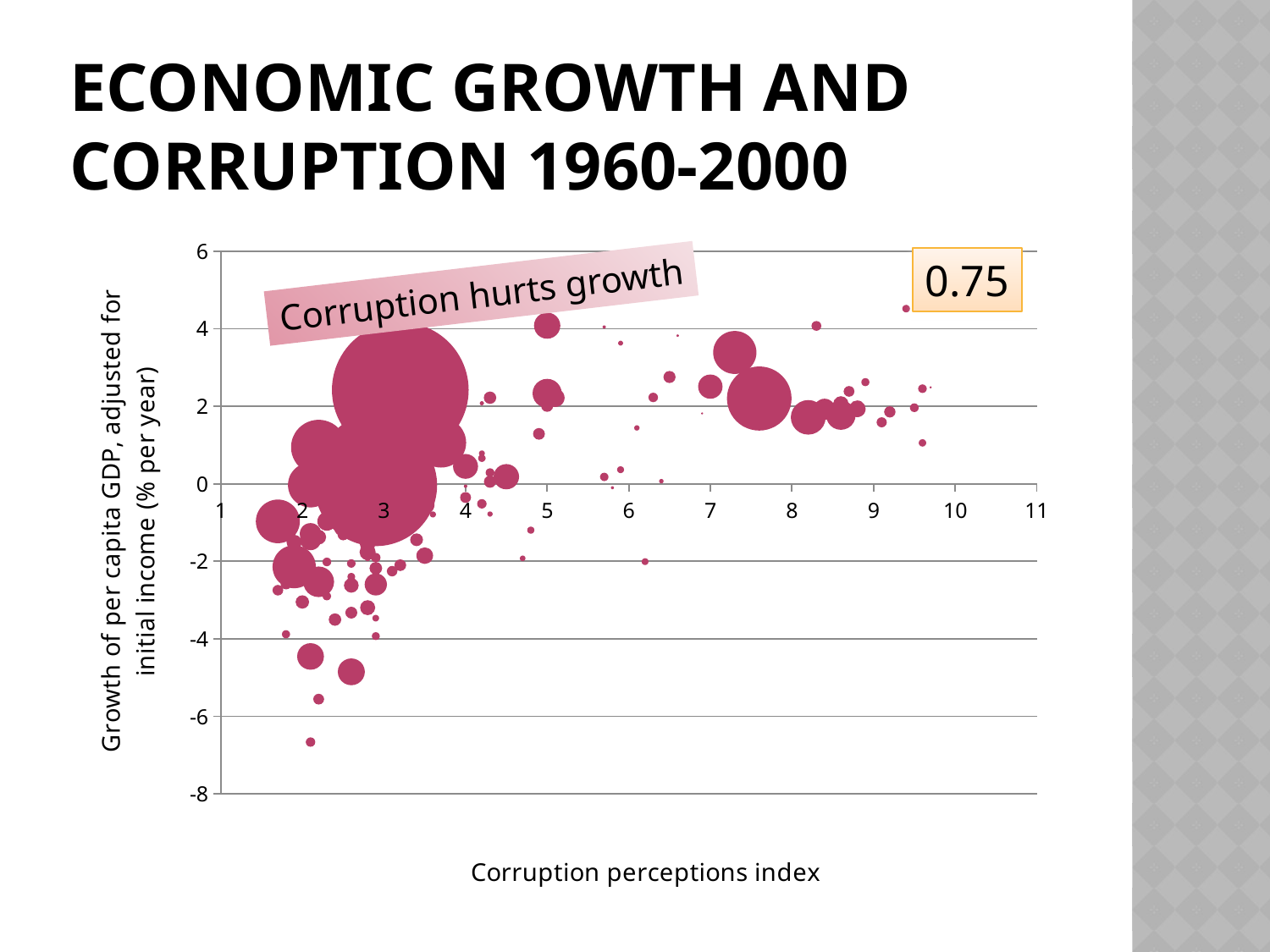
What number is shown in the box in the top right corner of the chart? 0.75 What text is written in the banner across the top of the chart? Corruption hurts growth Is the lowest plotted growth value on the chart greater or less than -6? less What kind of chart is shown on the slide? bubble chart Is the highest plotted growth value on the chart greater or less than 4? greater As the corruption perceptions index increases along the x axis, does growth of per capita GDP generally rise or fall? rise